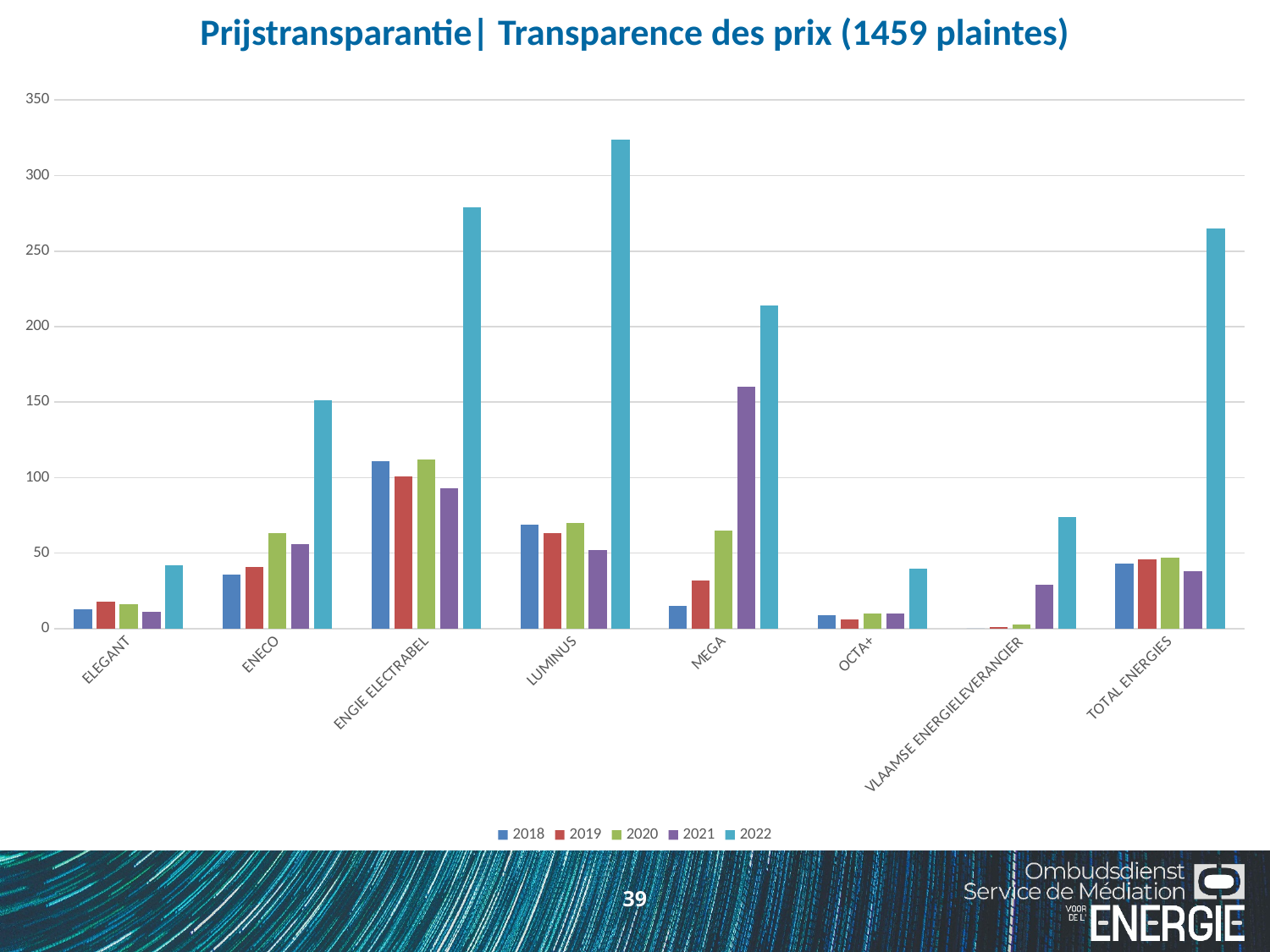
How many supplier categories are shown on the x axis? 8 Is the value for ENGIE ELECTRABEL in 2022 greater or less than 250? greater How many series does the legend list? 5 Is the value for OCTA+ in 2022 greater or less than 50? less Which supplier has the highest value for 2022? LUMINUS Which supplier has the lowest value for 2022? OCTA+ How many complaints (plaintes) does the chart title mention? 1459 Which is larger: the 2021 value for MEGA or the 2021 value for ENGIE ELECTRABEL? MEGA Is the value for LUMINUS in 2022 greater or less than 300? greater What kind of chart is shown on the slide? bar chart Do the values for MEGA rise or fall from 2018 to 2022? rise